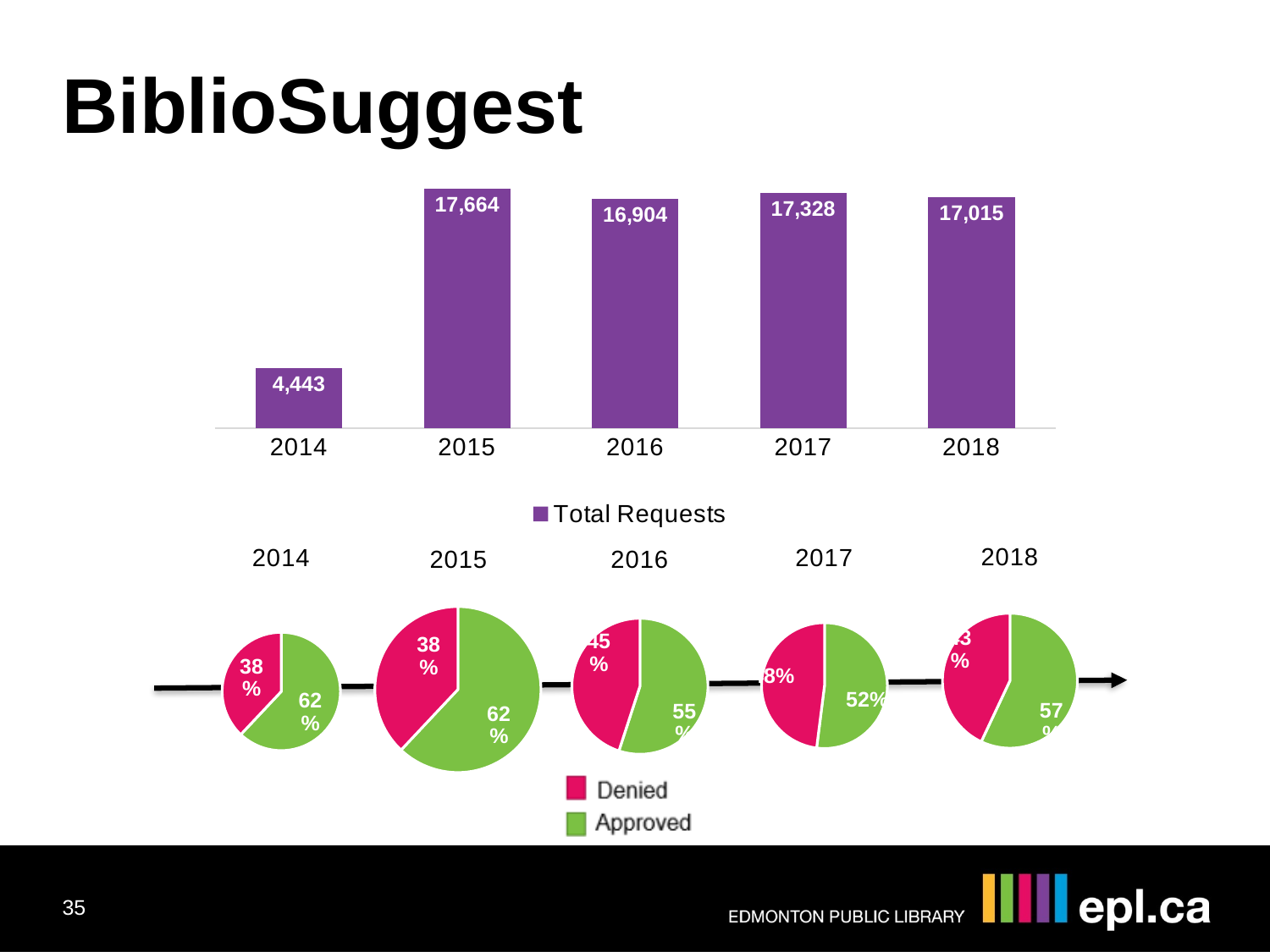
What kind of chart is the upper chart on the slide? bar chart In the bar chart, what is the difference in Total Requests between 2015 and 2014? 13,221 In the pie charts, what share of requests was Denied in 2015? 38% In the bar chart, which year has the lowest Total Requests? 2014 In the bar chart, what is the value for Total Requests in 2015? 17,664 How many years are shown in the bar chart? 5 In the bar chart, what is the value for Total Requests in 2018? 17,015 In the bar chart, which year has more Total Requests, 2016 or 2017? 2017 In the bar chart, what is the value for Total Requests in 2014? 4,443 What series name does the legend of the bar chart list? Total Requests In the pie charts, what share of requests was Approved in 2016? 55% In the bar chart, which year has the highest Total Requests? 2015